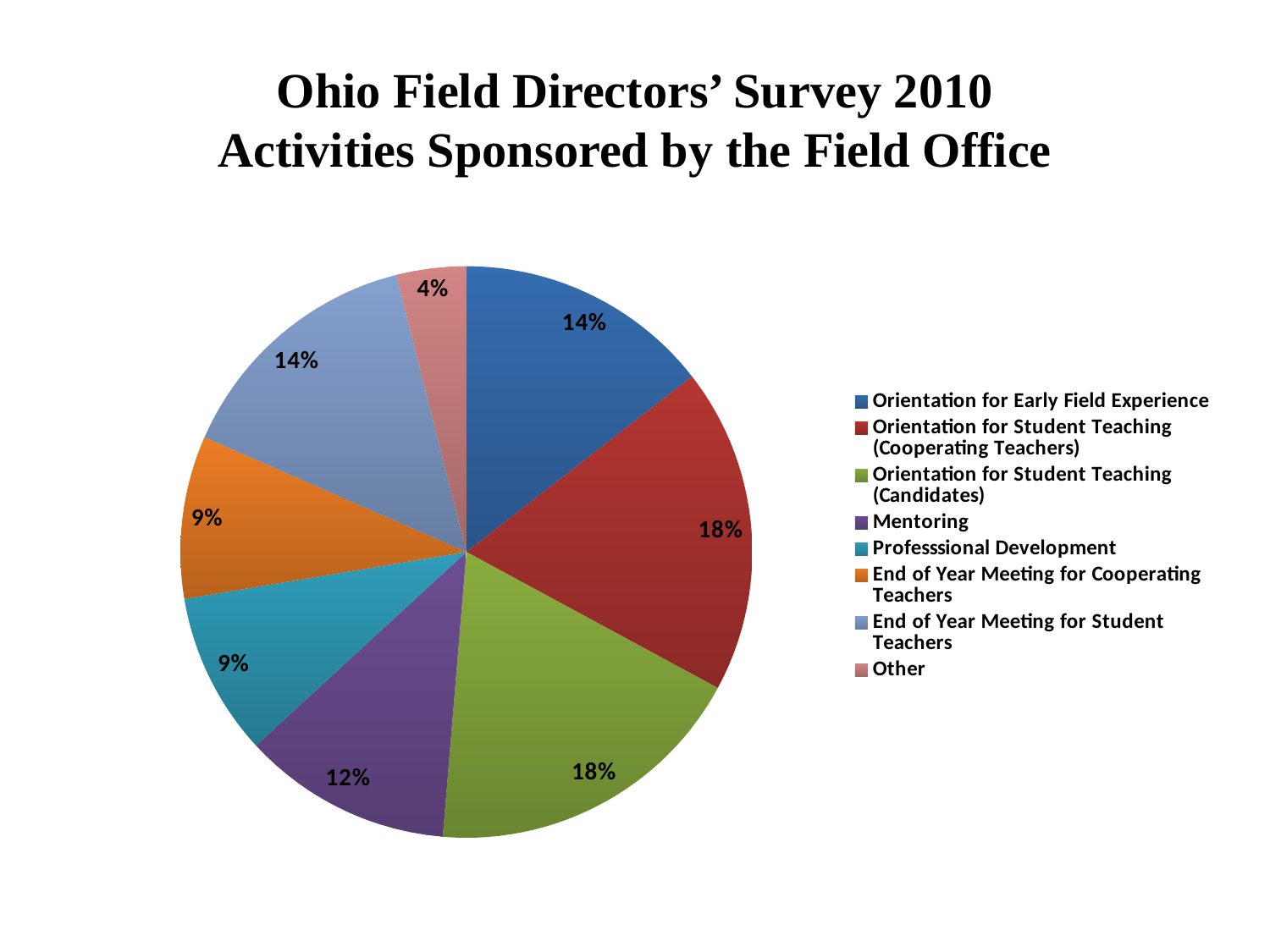
What kind of chart is shown on the slide? pie chart Which category has the smallest slice of the pie? Other What share of the pie is Orientation for Student Teaching (Candidates)? 18% How many categories does the legend list? 8 What share of the pie is Mentoring? 12% What share of the pie is Professsional Development? 9% What is the difference between the share for Mentoring and the share for Other? 8% What share of the pie is Orientation for Early Field Experience? 14% What share of the pie is Other? 4% What is the title of the chart? Ohio Field Directors' Survey 2010 Activities Sponsored by the Field Office What is the combined share of Orientation for Student Teaching (Cooperating Teachers) and Orientation for Student Teaching (Candidates)? 36% Which is larger, the share for Mentoring or the share for End of Year Meeting for Student Teachers? End of Year Meeting for Student Teachers